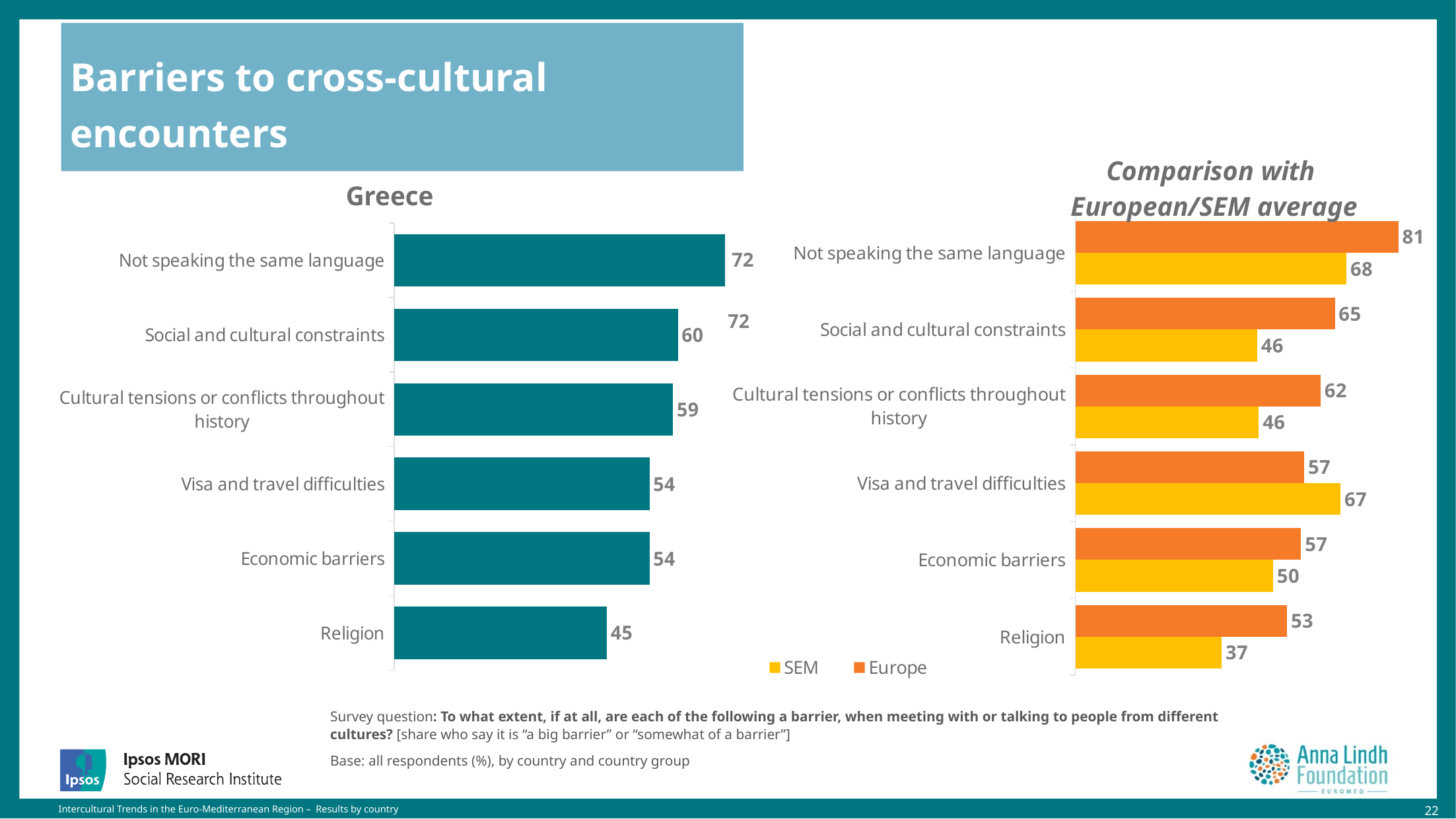
In the Comparison with European/SEM average chart, what is the difference between the Europe and SEM values for Social and cultural constraints? 19 In the Greece chart, what is the difference between Not speaking the same language and Religion? 27 In the Comparison with European/SEM average chart, what is the Europe value for Not speaking the same language? 81 In the Greece chart, what is the value for Not speaking the same language? 72 How many series does the legend of the Comparison with European/SEM average chart list? 2 In the Greece chart, what is the value for Religion? 45 In the Greece chart, which barrier has the lowest value? Religion What type of chart is the Greece chart? Bar chart In the Comparison with European/SEM average chart, which is larger for Visa and travel difficulties, SEM or Europe? SEM In the Comparison with European/SEM average chart, what is the SEM value for Religion? 37 In the Greece chart, which barrier has the highest value? Not speaking the same language How many barriers are listed in the Greece chart? 6